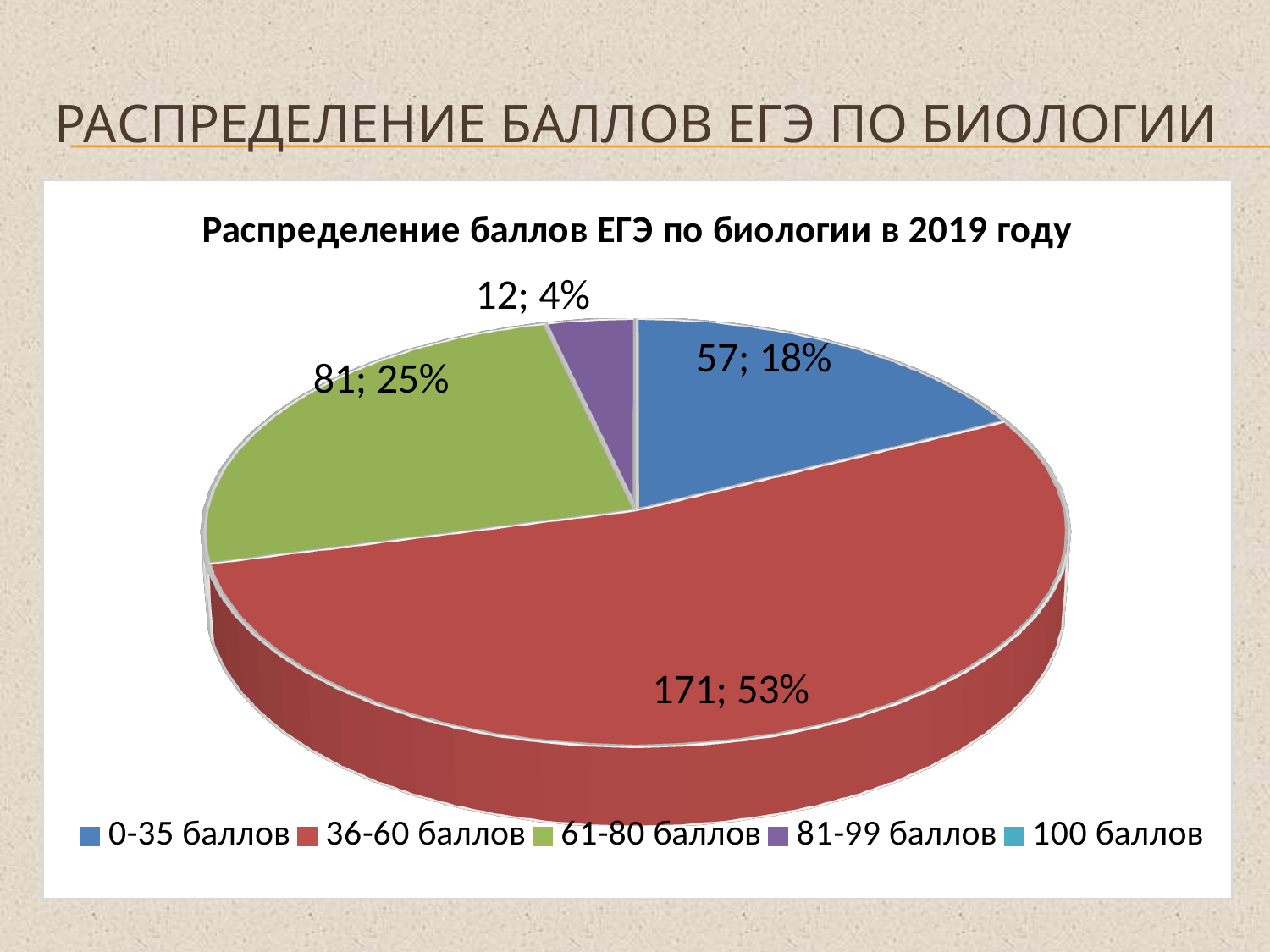
Which slice is larger: 61-80 баллов or 0-35 баллов? 61-80 баллов How many people scored 36-60 баллов according to the chart? 171 What type of chart is shown on the slide? pie chart What percentage share does the 81-99 баллов slice have? 4% What is the title of the chart? Распределение баллов ЕГЭ по биологии в 2019 году What colour is the 36-60 баллов slice in the chart? red Which score range has the largest slice of the pie? 36-60 баллов Which score range with a visible slice has the smallest share of the pie? 81-99 баллов What is the difference between the number of people scoring 36-60 баллов and those scoring 0-35 баллов? 114 What percentage of the pie does the 0-35 баллов slice represent? 18% What value is shown for the 61-80 баллов slice? 81 How many entries does the chart legend list? 5